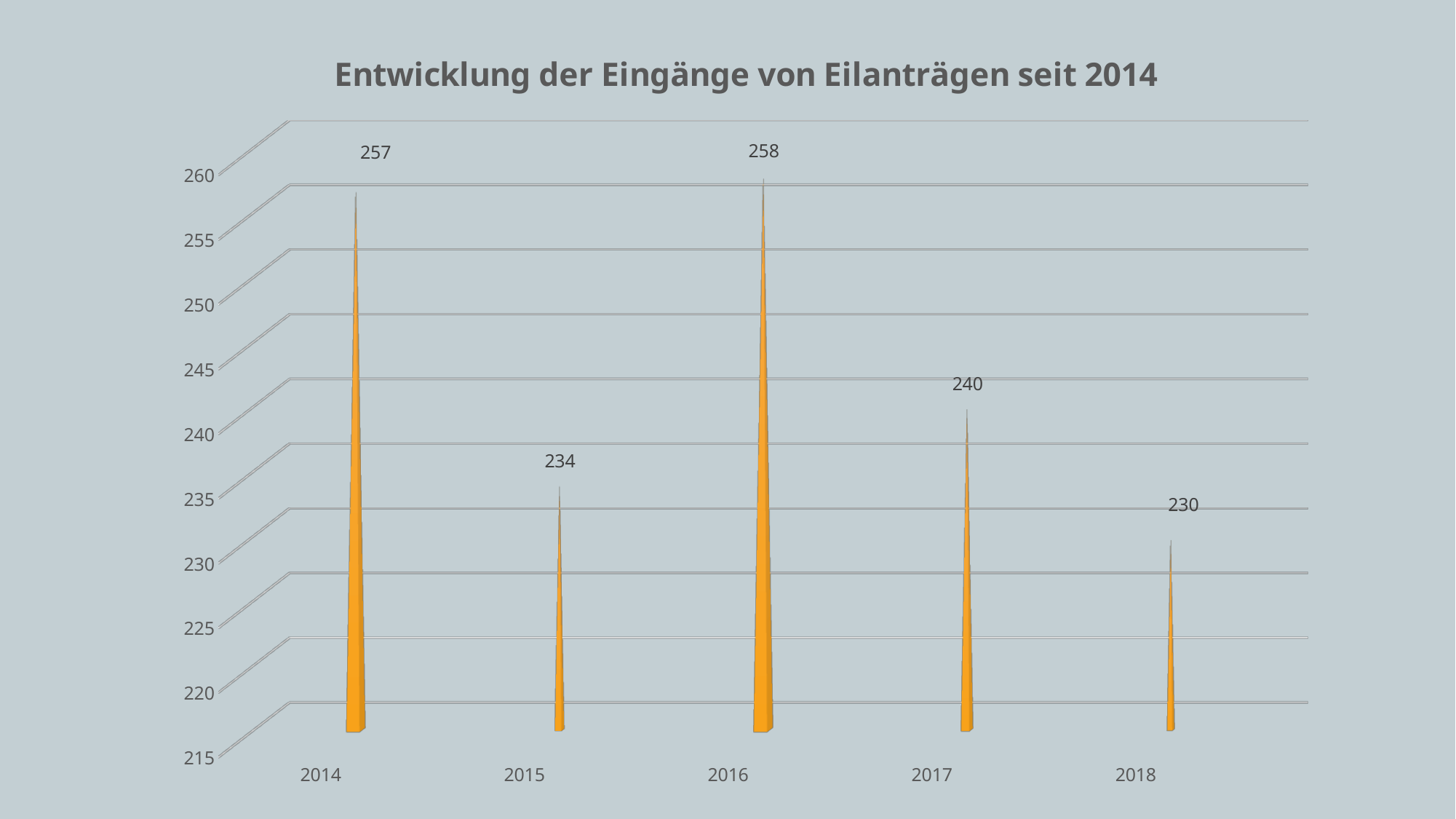
How many years are shown on the x axis? 5 Is the value for 2017 greater or less than 235? greater Which is larger, the value for 2015 or the value for 2017? 2017 Do the values rise or fall from 2016 to 2018? fall What is the difference between the values for 2017 and 2018? 10 What is the title of the chart? Entwicklung der Eingänge von Eilanträgen seit 2014 What is the value for 2014? 257 What is the value for 2018? 230 What kind of chart is this? bar chart What is the difference between the values for 2014 and 2015? 23 What is the value for 2016? 258 Which year has the lowest value? 2018